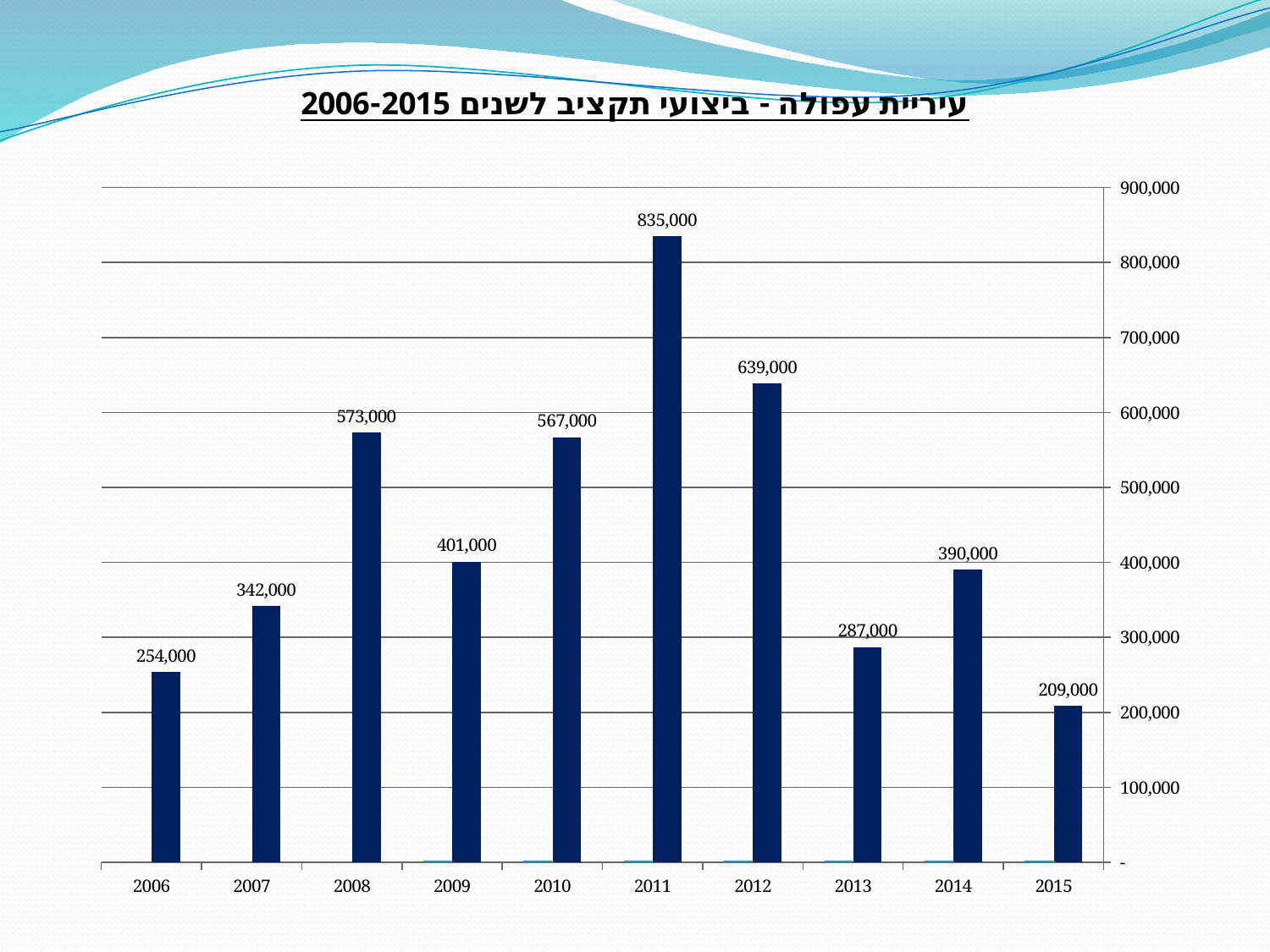
How many years are shown on the x axis? 10 Is the value for 2012 greater or less than 600,000? greater What kind of chart is shown on the slide? bar chart What is the value for 2006? 254,000 Which year has the lowest value? 2015 What is the value for 2014? 390,000 Do the values rise or fall from 2012 to 2013? fall Which is larger, the value for 2009 or the value for 2014? 2009 Which year has the highest value? 2011 What is the value for 2011? 835,000 What is the difference between the values for 2008 and 2010? 6,000 What is the difference between the values for 2011 and 2012? 196,000